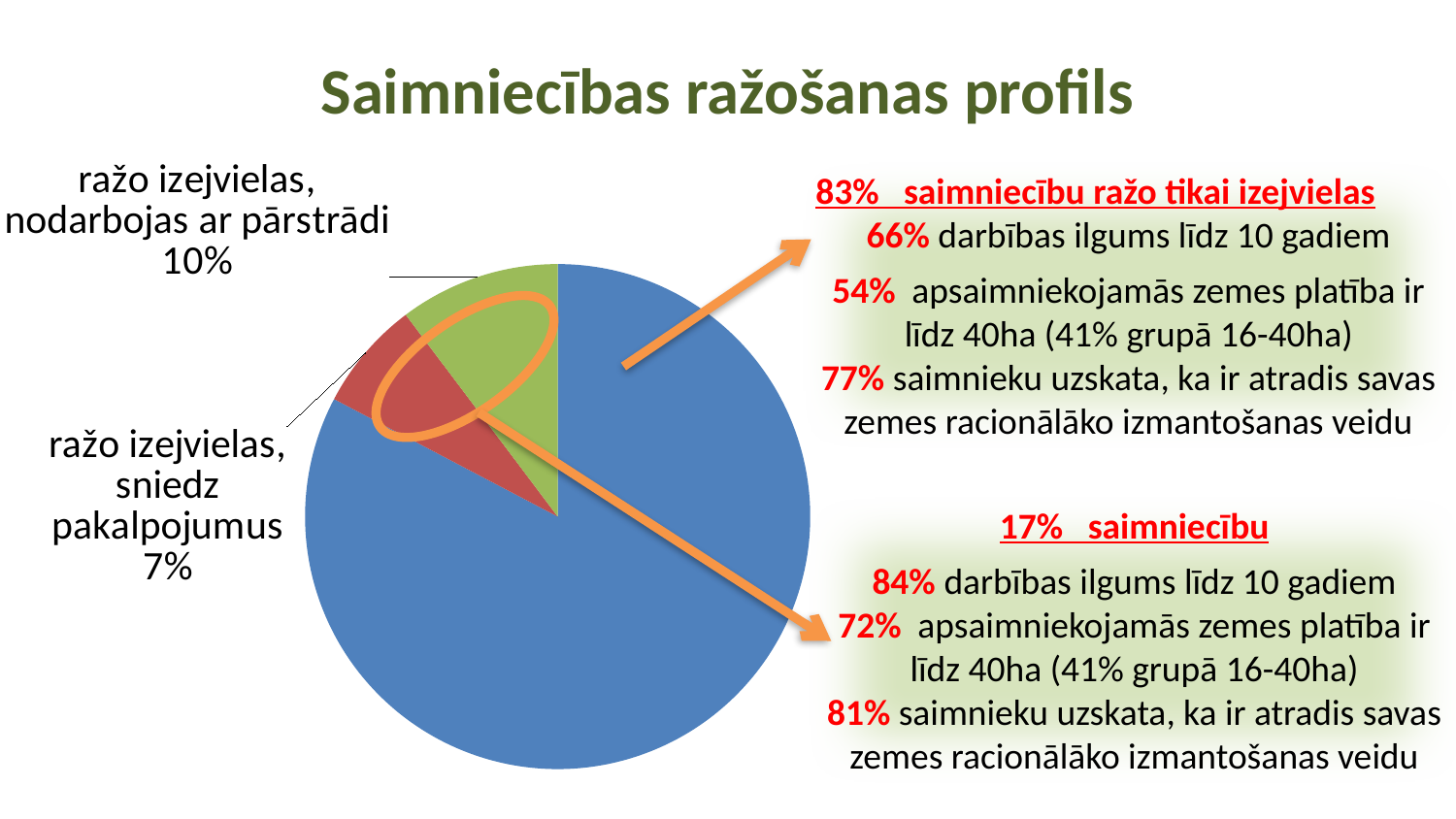
What share of the pie is labelled "ražo izejvielas, sniedz pakalpojumus"? 7% Which is larger: the slice "ražo izejvielas, nodarbojas ar pārstrādi" or the slice "ražo izejvielas, sniedz pakalpojumus"? ražo izejvielas, nodarbojas ar pārstrādi What colour is the slice labelled "ražo izejvielas, sniedz pakalpojumus 7%"? red What is the title of the slide with the pie chart? Saimniecības ražošanas profils Of the two labelled slices, which has the larger share? ražo izejvielas, nodarbojas ar pārstrādi What share of the pie is labelled "ražo izejvielas, nodarbojas ar pārstrādi"? 10% What is the difference in percentage points between the "ražo izejvielas, nodarbojas ar pārstrādi" slice and the "ražo izejvielas, sniedz pakalpojumus" slice? 3% What kind of chart is shown on the slide? pie chart Is the share of the "ražo izejvielas, sniedz pakalpojumus" slice greater or less than 10%? less How many slices does the pie chart have? 3 Of the two labelled slices, which has the smaller share? ražo izejvielas, sniedz pakalpojumus